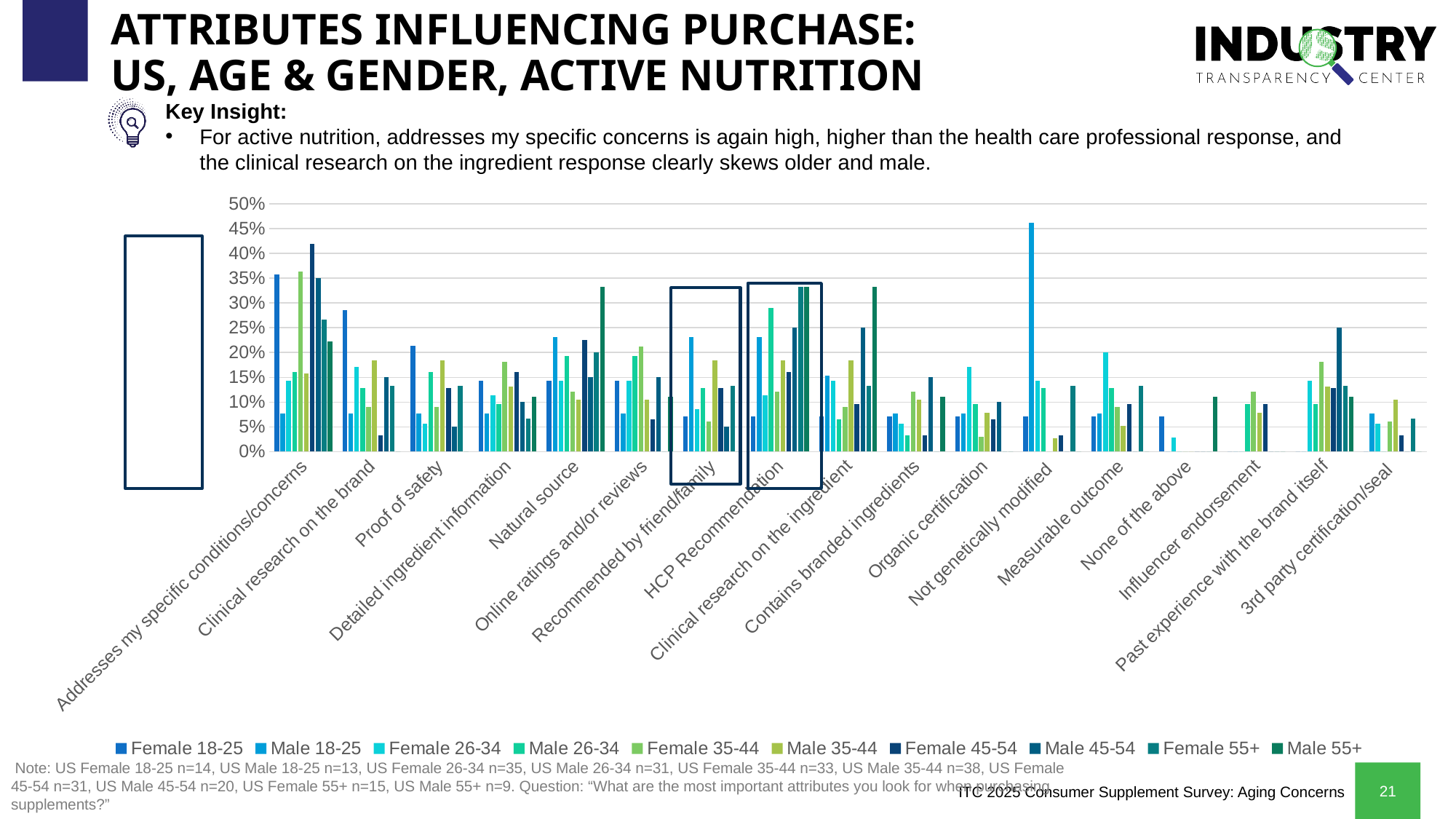
Is the value for Male 18-25 for Recommended by friend/family greater or less than 20%? greater Is the value for Male 18-25 for Not genetically modified greater or less than 40%? greater Is the value for Male 55+ for Natural source greater or less than 30%? greater What kind of chart is shown on the slide? Bar chart How many attribute categories are shown along the x axis? 17 Which series has the tallest bar for Not genetically modified? Male 18-25 Which category contains the tallest bar in the chart? Not genetically modified For Addresses my specific conditions/concerns, which is larger: the Female 45-54 value or the Male 18-25 value? Female 45-54 How many series does the legend list? 10 What is the highest value shown on the y axis? 50%